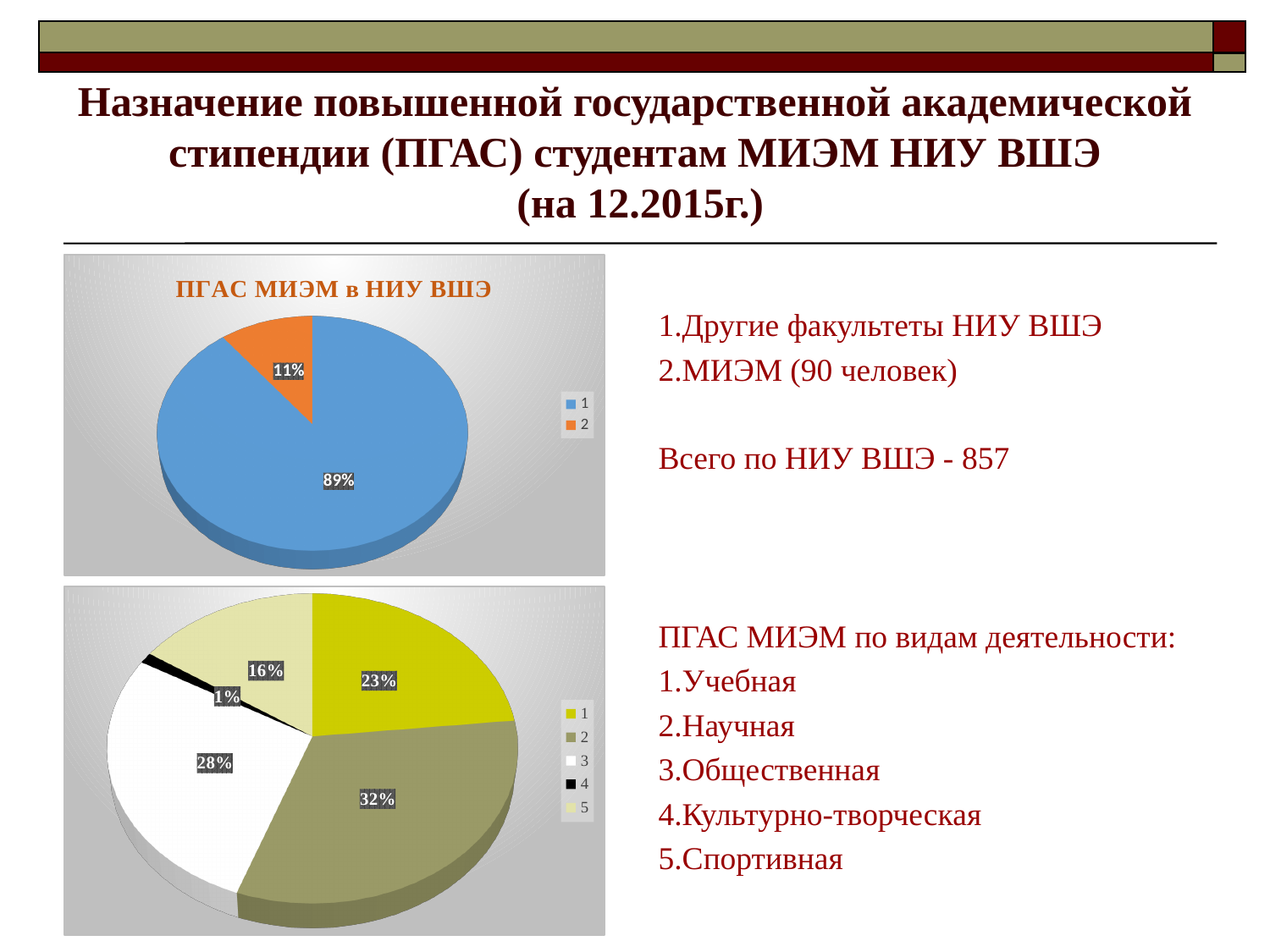
How many series does the legend of the top chart titled "ПГАС МИЭМ в НИУ ВШЭ" list? 2 In the bottom pie chart, what share does slice 4 have? 1% In the bottom pie chart, which slice is the largest? 2 In the bottom pie chart, what share does slice 2 have? 32% In the bottom pie chart, how many slices are there? 5 In the bottom pie chart, which is larger, slice 1 or slice 3? 3 In the bottom pie chart, what is the difference between the shares of slice 3 and slice 5? 12% In the bottom pie chart, which slice is the smallest? 4 In the top chart titled "ПГАС МИЭМ в НИУ ВШЭ", what is the difference between the shares of slice 1 and slice 2? 78% What kind of chart is the top chart titled "ПГАС МИЭМ в НИУ ВШЭ"? pie chart In the top chart titled "ПГАС МИЭМ в НИУ ВШЭ", what share does slice 1 have? 89%